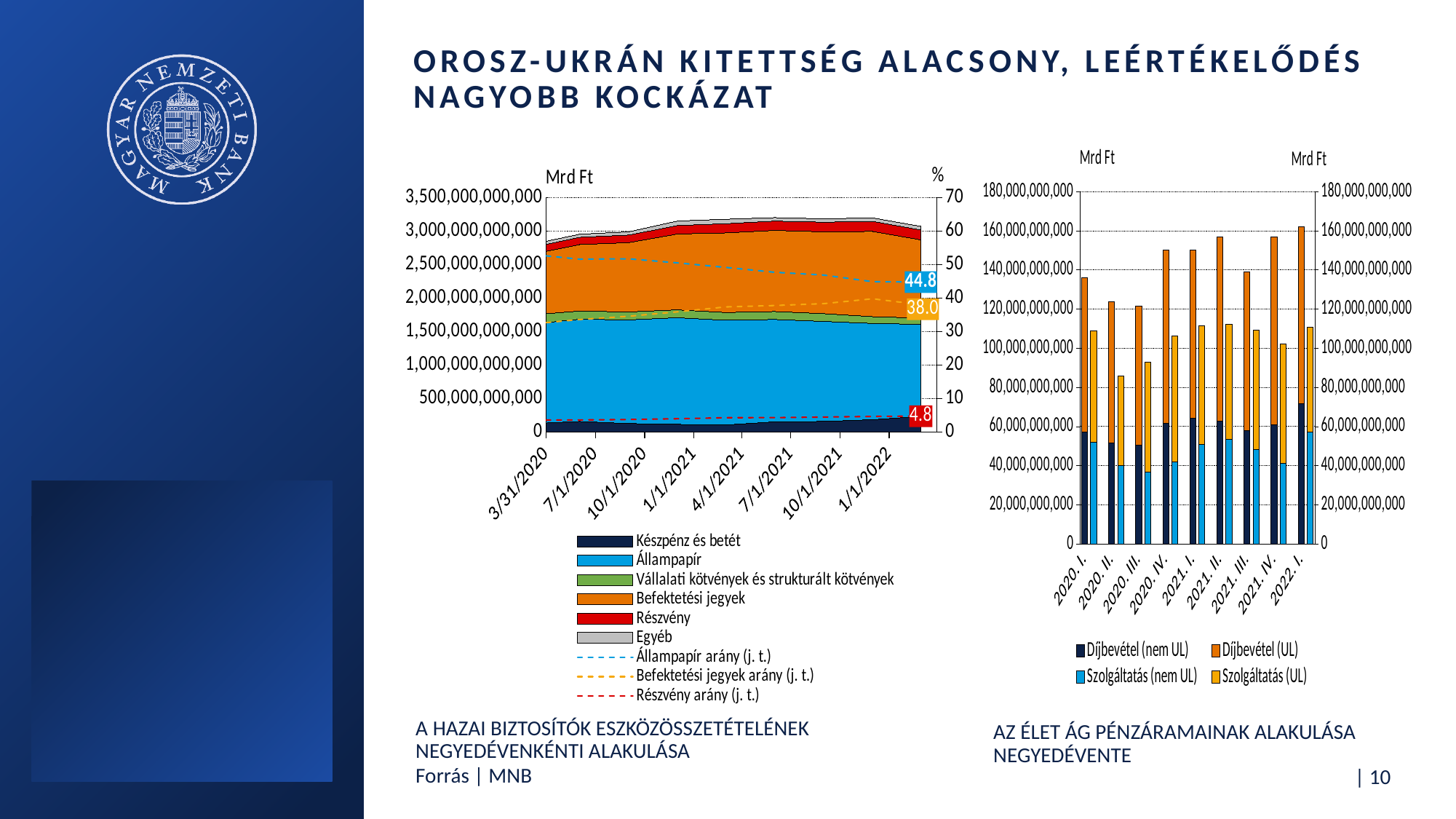
In the left chart, what value is labelled for Befektetési jegyek arány (j. t.) at the last point? 38.0 In the left chart (A hazai biztosítók eszközösszetételének negyedévenkénti alakulása), what value is labelled for Állampapír arány (j. t.) at the last point? 44.8 In the right chart, how many series does the legend list? 4 In the left chart, what value is labelled for Részvény arány (j. t.) at the last point? 4.8 What kind of chart is the right chart (Az élet ág pénzáramainak alakulása negyedévente)? bar chart In the left chart, how many series does the legend list? 9 In the right chart, which quarter has the highest total Díjbevétel (nem UL + UL) bar? 2022. I. In the right chart, is the total Szolgáltatás (nem UL + UL) bar for 2020. II. greater or less than 100,000,000,000? less In the left chart, what is the difference between the labelled Állampapír arány (44.8) and Befektetési jegyek arány (38.0) at the last point? 6.8 In the left chart, how many date labels are shown on the x axis? 8 In the right chart, how many quarters are shown on the x axis? 9 In the left chart, does the Állampapír arány (j. t.) dashed line rise or fall from 3/31/2020 to the end of the period? fall